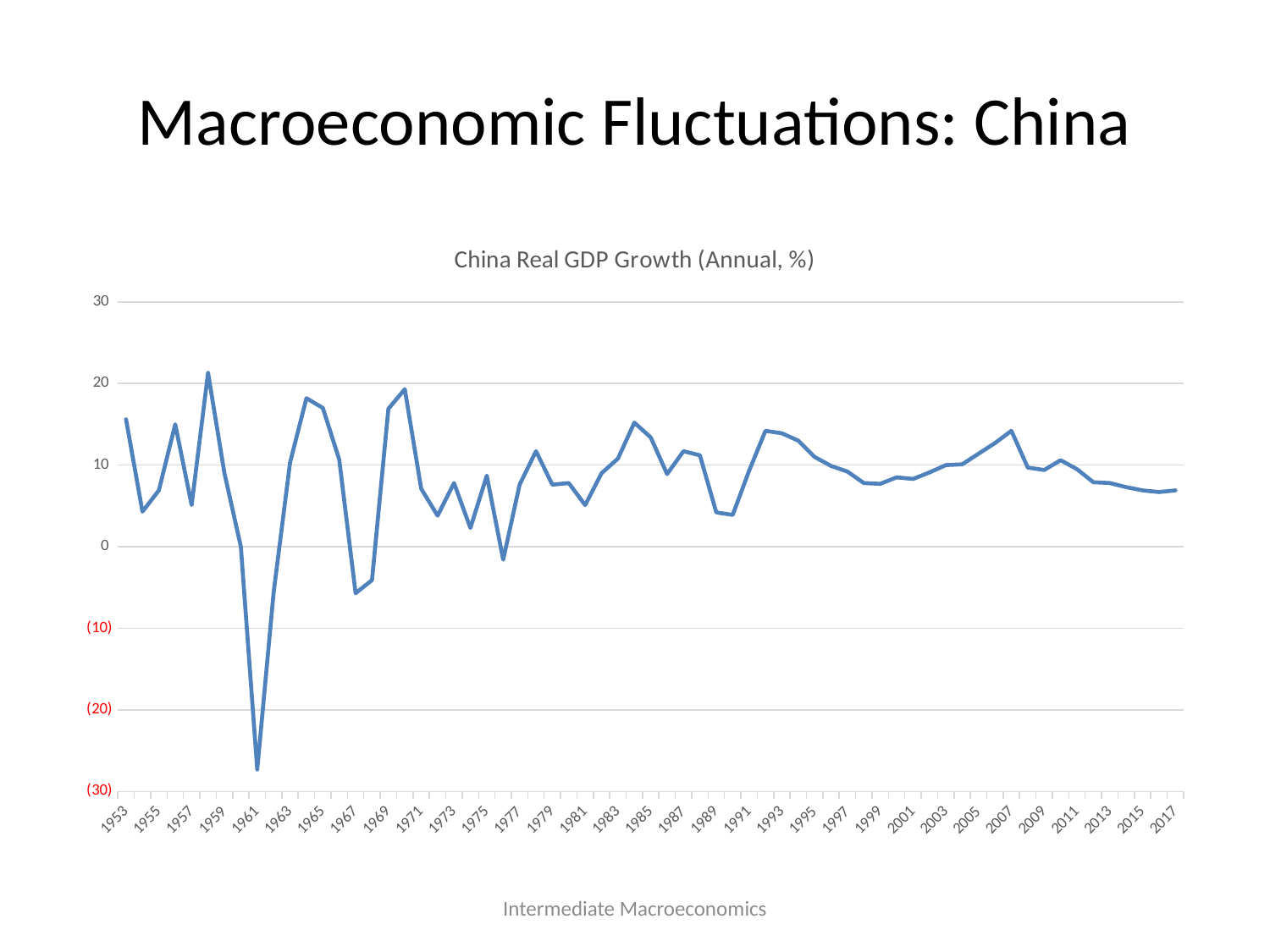
Which year has the larger value, 2007 or 2017? 2007 What is the title of the chart? China Real GDP Growth (Annual, %) Is the value for 1953 greater or less than 10? greater Is the value for 2017 greater or less than 10? less What kind of chart is shown on the slide? line chart Do the values generally rise or fall from 2007 to 2017? fall Is the value for 1961 greater or less than (20)? less In which year does the line reach its lowest value? 1961 Which year has the larger value, 1961 or 1965? 1965